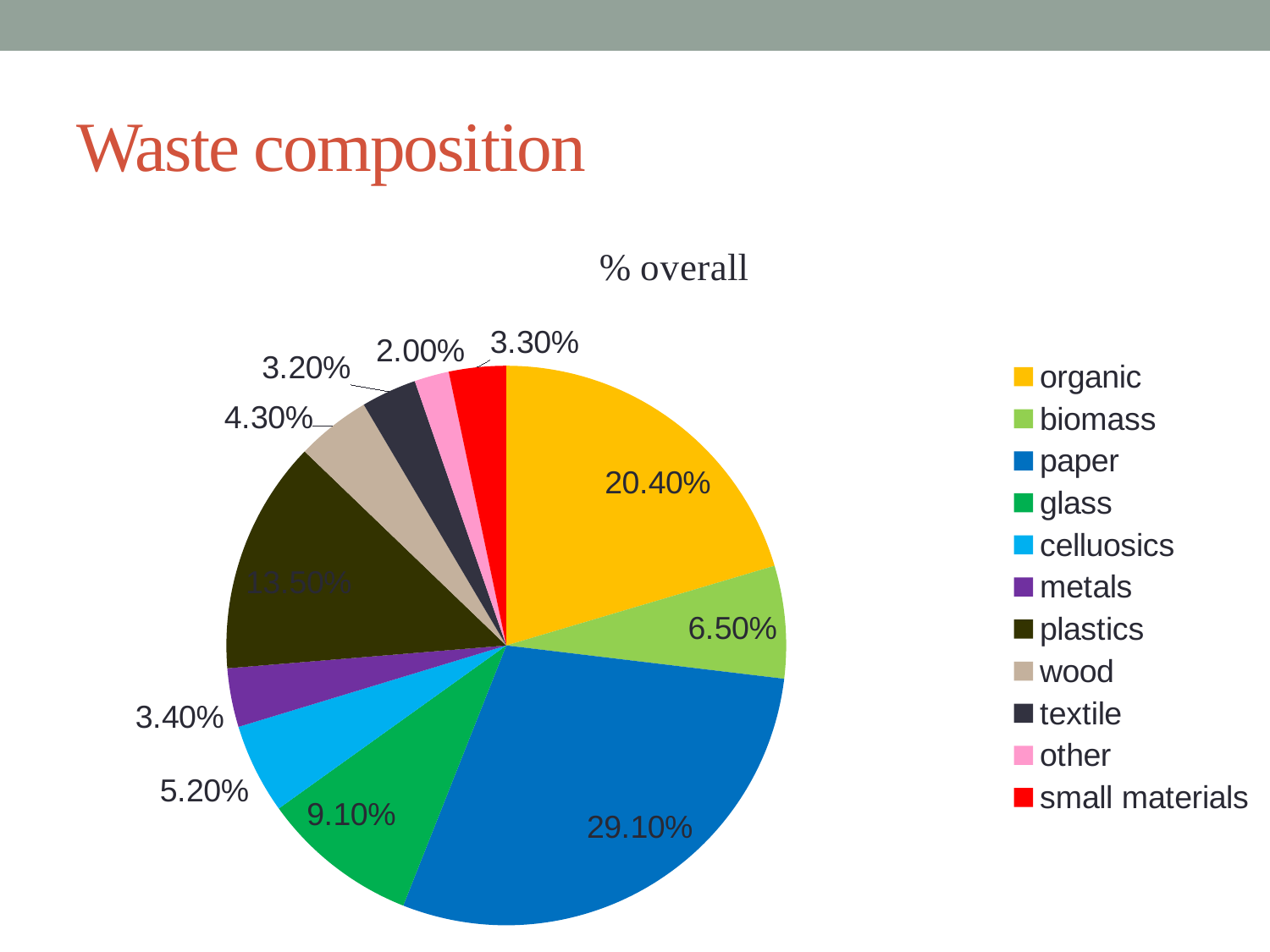
What is the value for paper? 29.10% Which category has the smallest share of the pie? other Which is larger, the value for biomass or the value for celluosics? biomass What is the chart's title? % overall How many categories does the legend list? 11 What is the difference between the values for paper and organic? 8.70% What is the value for wood? 4.30% What type of chart is shown on the slide? pie chart What is the value for organic? 20.40% What is the value for plastics? 13.50% What is the value for glass? 9.10% Which category has the largest share of the pie? paper